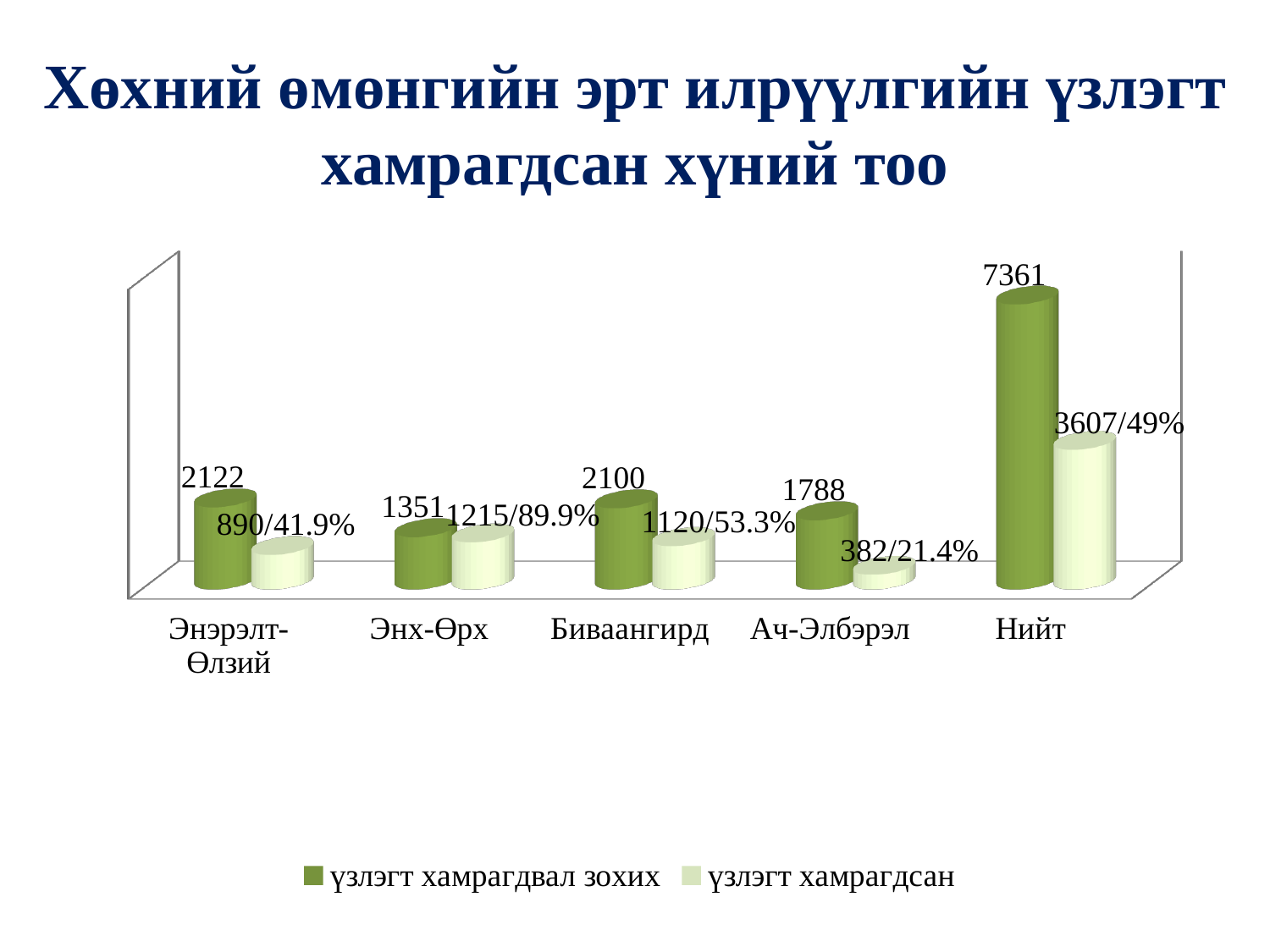
What is the value of the "үзлэгт хамрагдвал зохих" series for Нийт? 7361 What kind of chart is shown on the slide? Bar chart What is the difference between the "үзлэгт хамрагдвал зохих" value (7361) and the "үзлэгт хамрагдсан" count (3607) for Нийт? 3754 Which category has the lowest value in the "үзлэгт хамрагдсан" series? Ач-Элбэрэл What data label is shown for the "үзлэгт хамрагдсан" series for Ач-Элбэрэл? 382/21.4% Which is larger in the "үзлэгт хамрагдвал зохих" series: Энх-Өрх or Ач-Элбэрэл? Ач-Элбэрэл What is the value of the "үзлэгт хамрагдвал зохих" series for Энэрэлт-Өлзий? 2122 What data label is shown for the "үзлэгт хамрагдсан" series for Энх-Өрх? 1215/89.9% How many series does the legend list? 2 Which category has the highest value in the "үзлэгт хамрагдвал зохих" series? Нийт Which category has the lowest value in the "үзлэгт хамрагдвал зохих" series? Энх-Өрх How many categories are shown on the x axis? 5